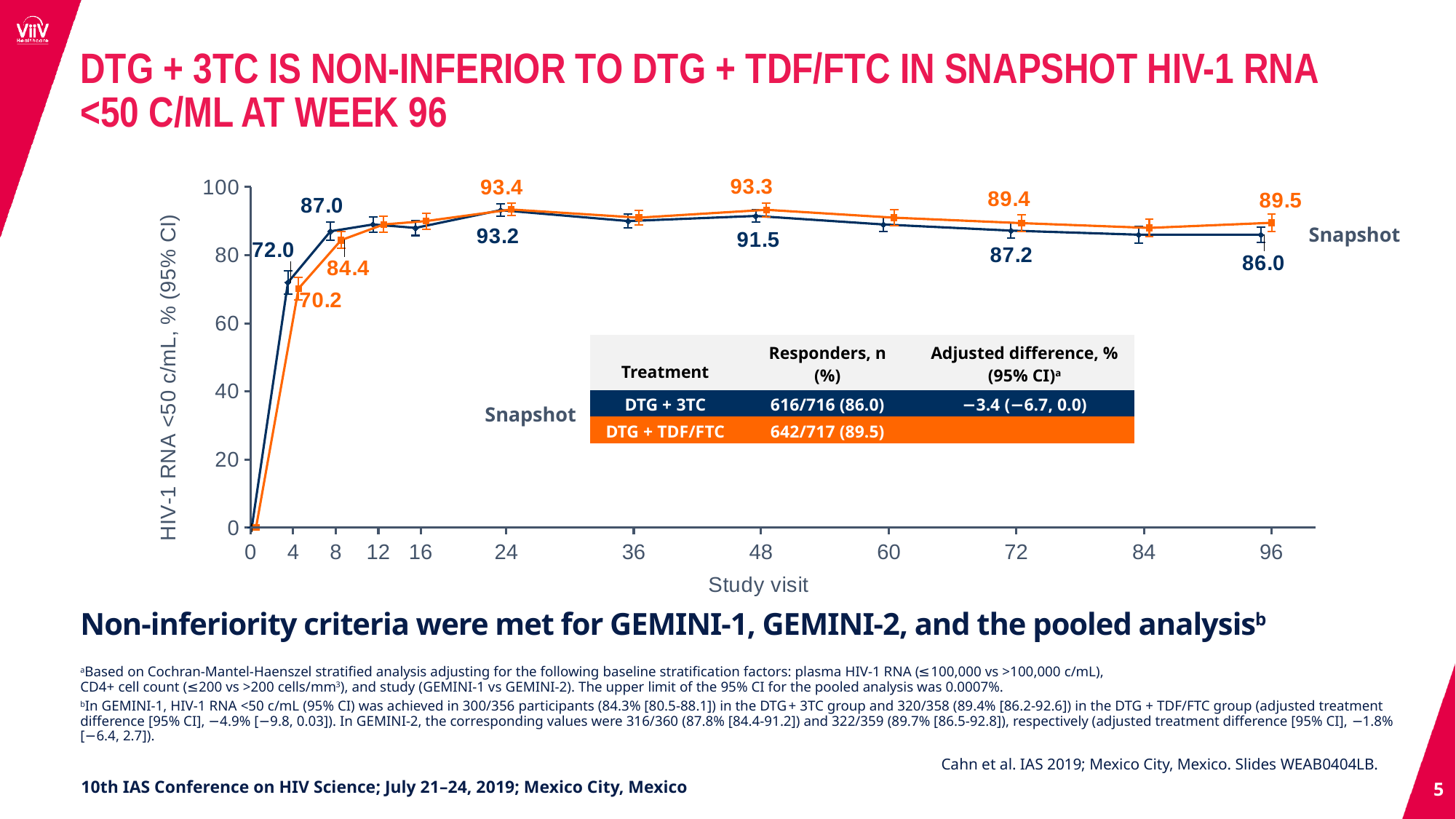
What kind of chart is shown on the slide? line chart What is the labelled value for the DTG + TDF/FTC (orange) line at week 96? 89.5 What is the labelled value for the DTG + TDF/FTC (orange) line at week 8? 84.4 Between week 48 and week 96, does the DTG + 3TC (dark blue) line rise or fall? fall What is the difference between the DTG + TDF/FTC and DTG + 3TC labelled values at week 96? 3.5 What is the labelled value for the DTG + 3TC (dark blue) line at week 96? 86.0 What is the labelled value for the DTG + 3TC (dark blue) line at week 4? 72.0 What is the labelled value for the DTG + TDF/FTC (orange) line at week 48? 93.3 At week 72, which line has the higher labelled value, DTG + 3TC or DTG + TDF/FTC? DTG + TDF/FTC What is the difference between the DTG + 3TC and DTG + TDF/FTC labelled values at week 8? 2.6 What is the label of the x axis of the chart? Study visit Is the value for the DTG + 3TC line at week 36 greater or less than 80? greater